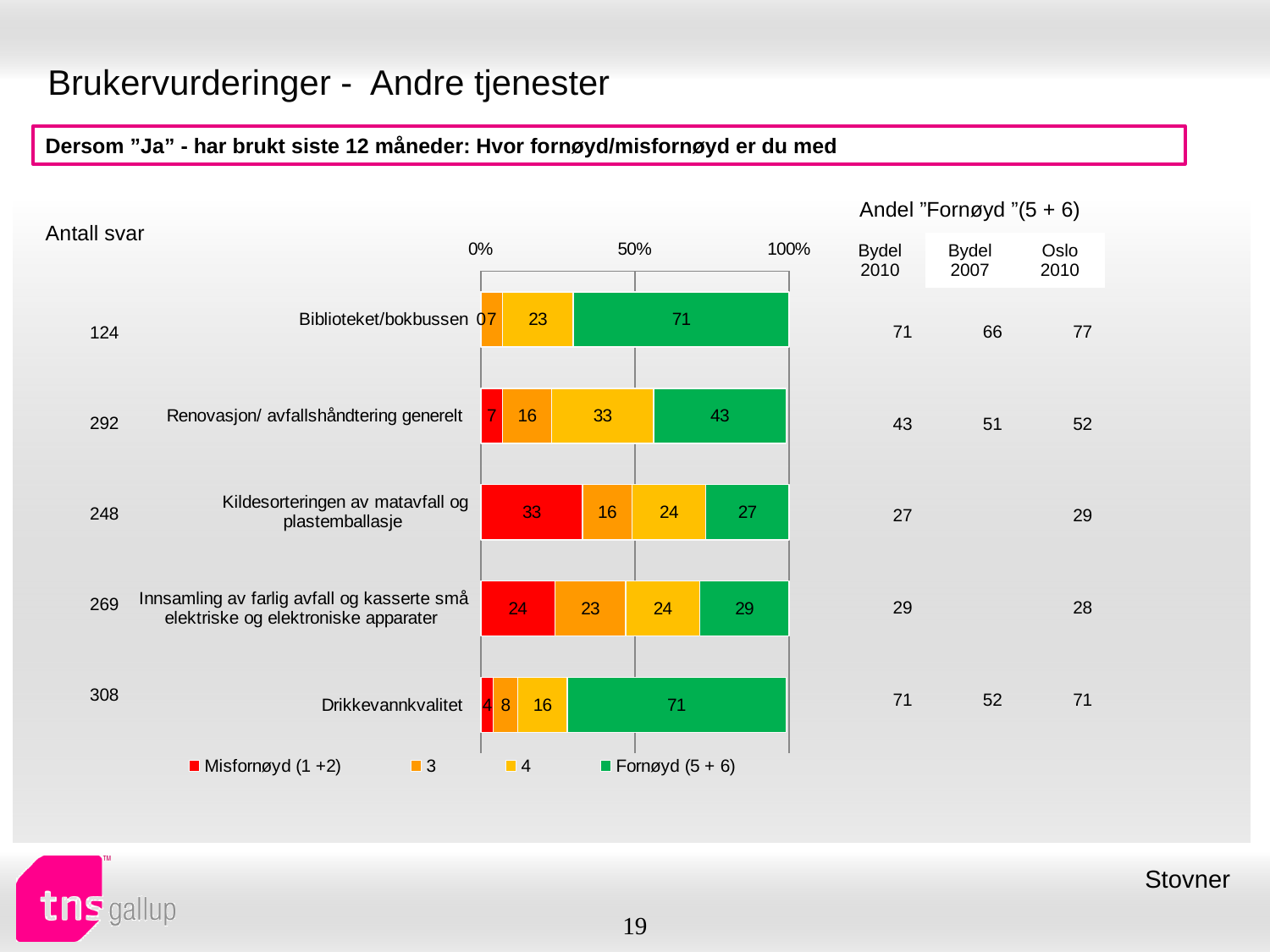
What is the total of the stacked bar for Innsamling av farlig avfall og kasserte små elektriske og elektroniske apparater? 100 How many categories are shown in the chart? 5 What kind of chart is shown on the slide? Stacked bar chart Which category has the lowest Fornøyd (5 + 6) value? Kildesorteringen av matavfall og plastemballasje What is the difference between the Fornøyd (5 + 6) values for Renovasjon/ avfallshåndtering generelt and Kildesorteringen av matavfall og plastemballasje? 16 How many series does the legend list? 4 What is the value of the '3' segment for Renovasjon/ avfallshåndtering generelt? 16 What is the value of the Misfornøyd (1 +2) segment for Kildesorteringen av matavfall og plastemballasje? 33 What is the value of the '4' segment for Drikkevannkvalitet? 16 What is the value of the Fornøyd (5 + 6) segment for Biblioteket/bokbussen? 71 Which category has the highest Misfornøyd (1 +2) value? Kildesorteringen av matavfall og plastemballasje Which has a larger Fornøyd (5 + 6) value: Renovasjon/ avfallshåndtering generelt or Innsamling av farlig avfall og kasserte små elektriske og elektroniske apparater? Renovasjon/ avfallshåndtering generelt